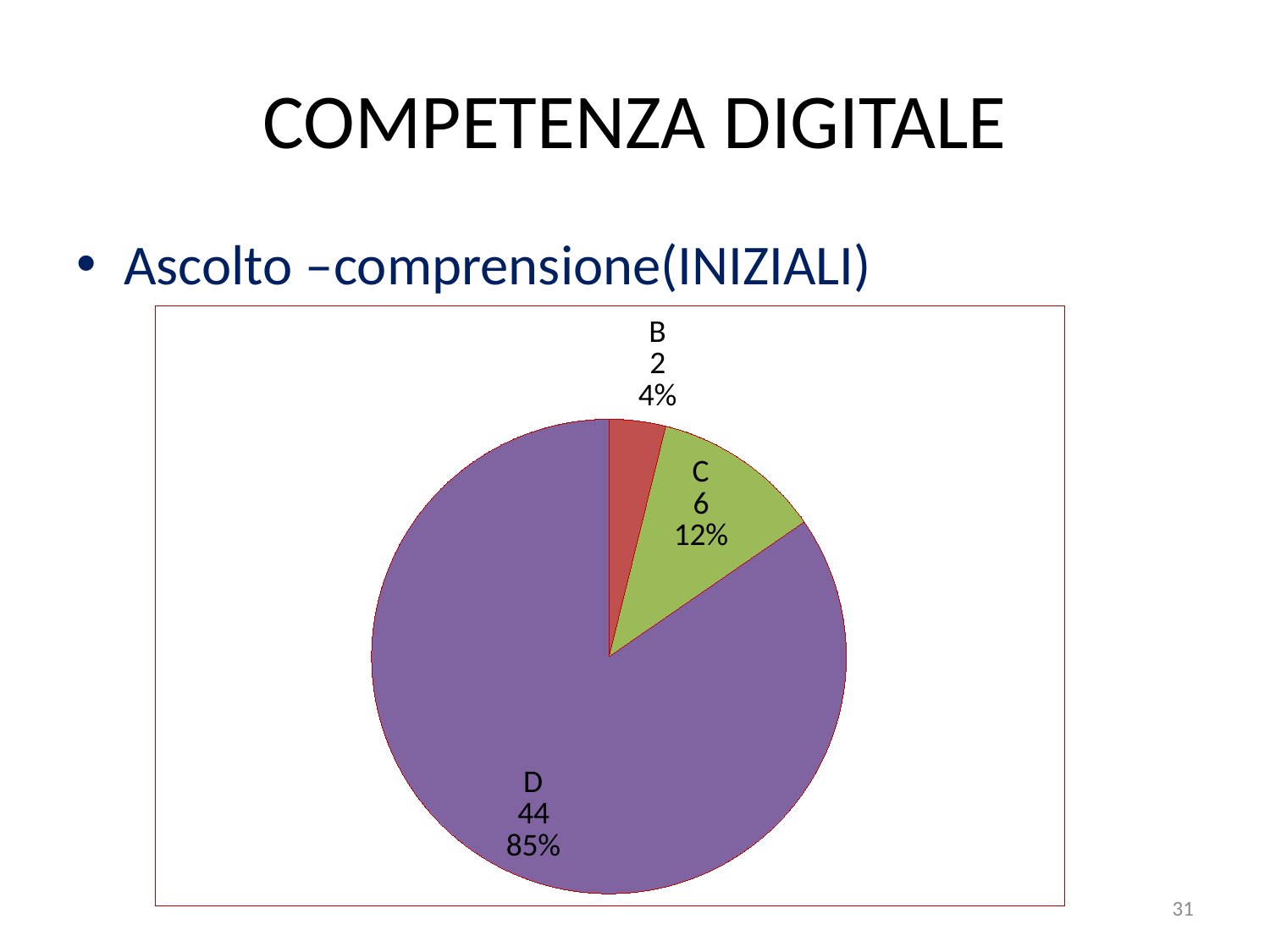
What kind of chart is shown on the slide? pie chart Which is larger, the value for C or the value for B? C What is the value for category B? 2 How many slices does the pie chart have? 3 What percentage share does slice D have? 85% What is the value for category D? 44 Which category has the smallest slice? B What percentage share does slice B have? 4% What is the difference between the values for D and C? 38 Which category has the largest slice? D What percentage share does slice C have? 12% What is the value for category C? 6